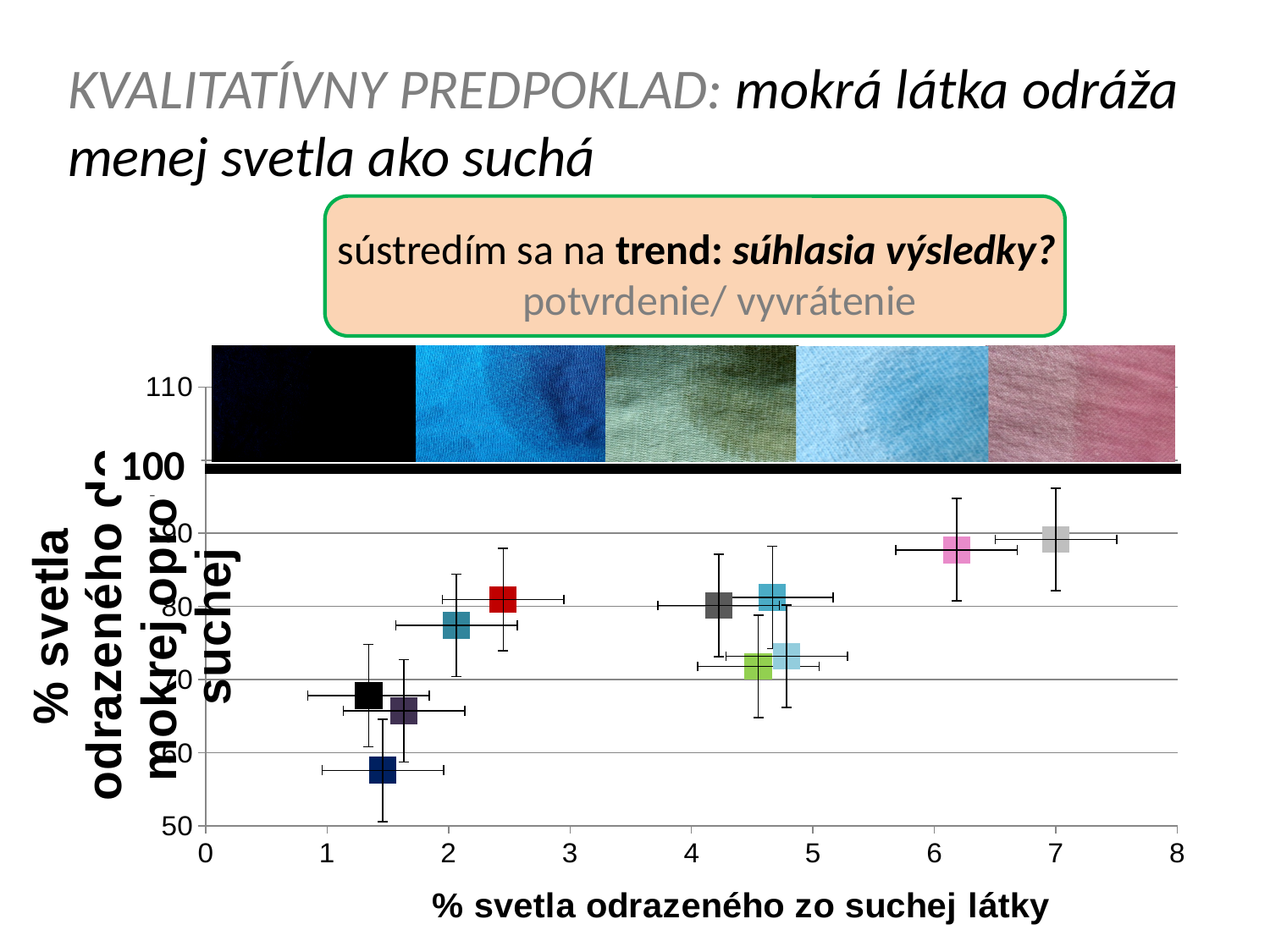
Which has the larger y value, the dark gray point or the light green point? the dark gray point Which point has the lowest y value on the chart? the navy (dark blue) point Is the y value of the navy (dark blue) point greater or less than 70? less Is the x value of the pink point greater or less than 6? greater How many data points are plotted on the chart? 11 What is the title of the x axis of the chart? % svetla odrazeného zo suchej látky Is the y value of the pink point greater or less than 80? greater What kind of chart is shown on the slide? scatter chart Do the y values of the points generally rise or fall as the x value increases? rise What is the highest value shown on the x axis of the chart? 8 Which point lies furthest to the right on the chart? the light gray point